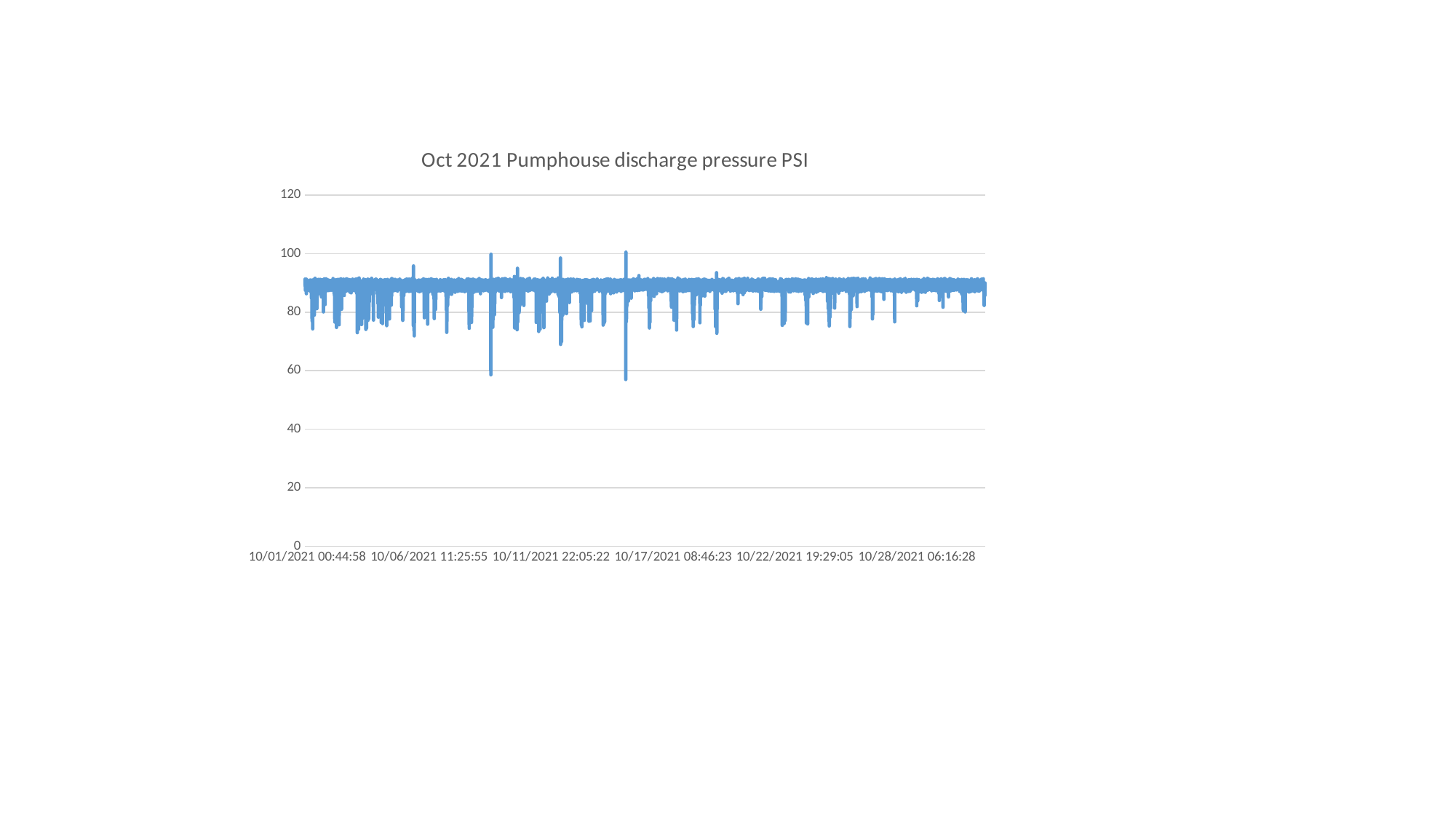
Over the month, does the baseline pressure rise strongly, fall strongly, or stay roughly flat? roughly flat What is the first date label on the x axis? 10/01/2021 00:44:58 Is the typical (baseline) discharge pressure greater or less than 80? greater What is the title of the chart? Oct 2021 Pumphouse discharge pressure PSI Is the lowest value reached on the chart greater or less than 60? less Is the lowest dip on the chart greater or less than 40? greater What is the last date label on the x axis? 10/28/2021 06:16:28 What is the highest value labelled on the vertical axis? 120 How many date labels are shown along the x axis? 6 What kind of chart is shown on the slide? line chart